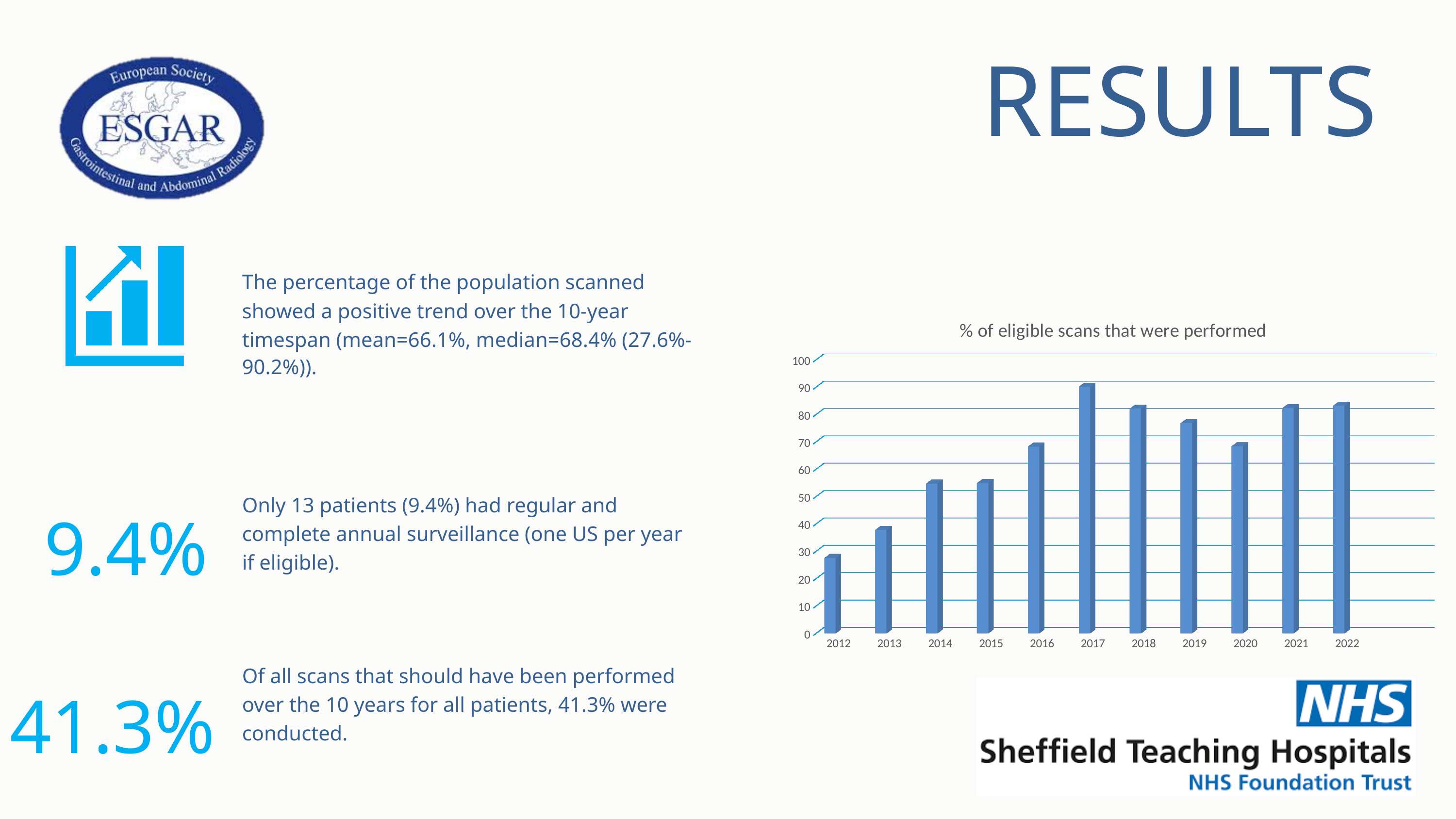
Which year has the larger value, 2019 or 2020? 2019 Which year has the lowest percentage of eligible scans performed? 2012 Which year has the larger value, 2013 or 2014? 2014 Which year has the highest percentage of eligible scans performed? 2017 Overall, do the values rise or fall from 2012 to 2022? rise What kind of chart is shown on the slide? bar chart Is the value for 2013 greater or less than 40? less Is the value for 2017 greater or less than 80? greater Is the value for 2014 greater or less than 50? greater How many years are shown on the x axis of the chart? 11 What is the title of the chart? % of eligible scans that were performed